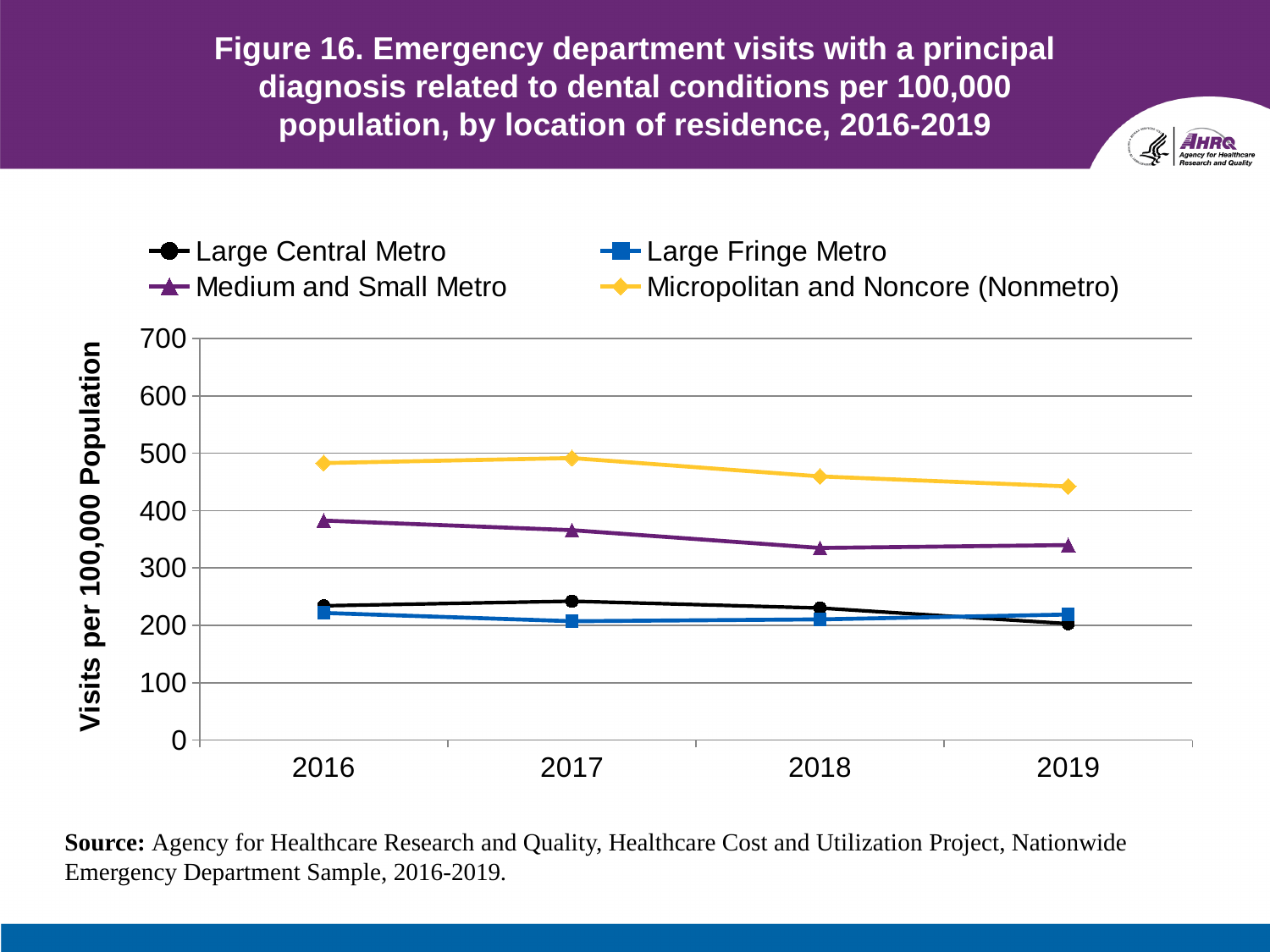
What kind of chart is shown on the slide? line chart Which location of residence has the highest rate of emergency department visits in 2019? Micropolitan and Noncore (Nonmetro) How many years are plotted along the x axis? 4 Does the Large Central Metro line rise or fall from 2017 to 2019? fall Is the value for Large Central Metro in 2019 greater or less than 300? less Does the Micropolitan and Noncore (Nonmetro) line rise or fall from 2017 to 2019? fall What is the title of the y axis? Visits per 100,000 Population In 2016, which is larger: the value for Medium and Small Metro or the value for Large Fringe Metro? Medium and Small Metro How many series does the legend list? 4 Which location of residence has the lowest rate of emergency department visits in 2019? Large Central Metro Is the value for Medium and Small Metro in 2018 greater or less than 400? less Is the value for Micropolitan and Noncore (Nonmetro) in 2017 greater or less than 400? greater